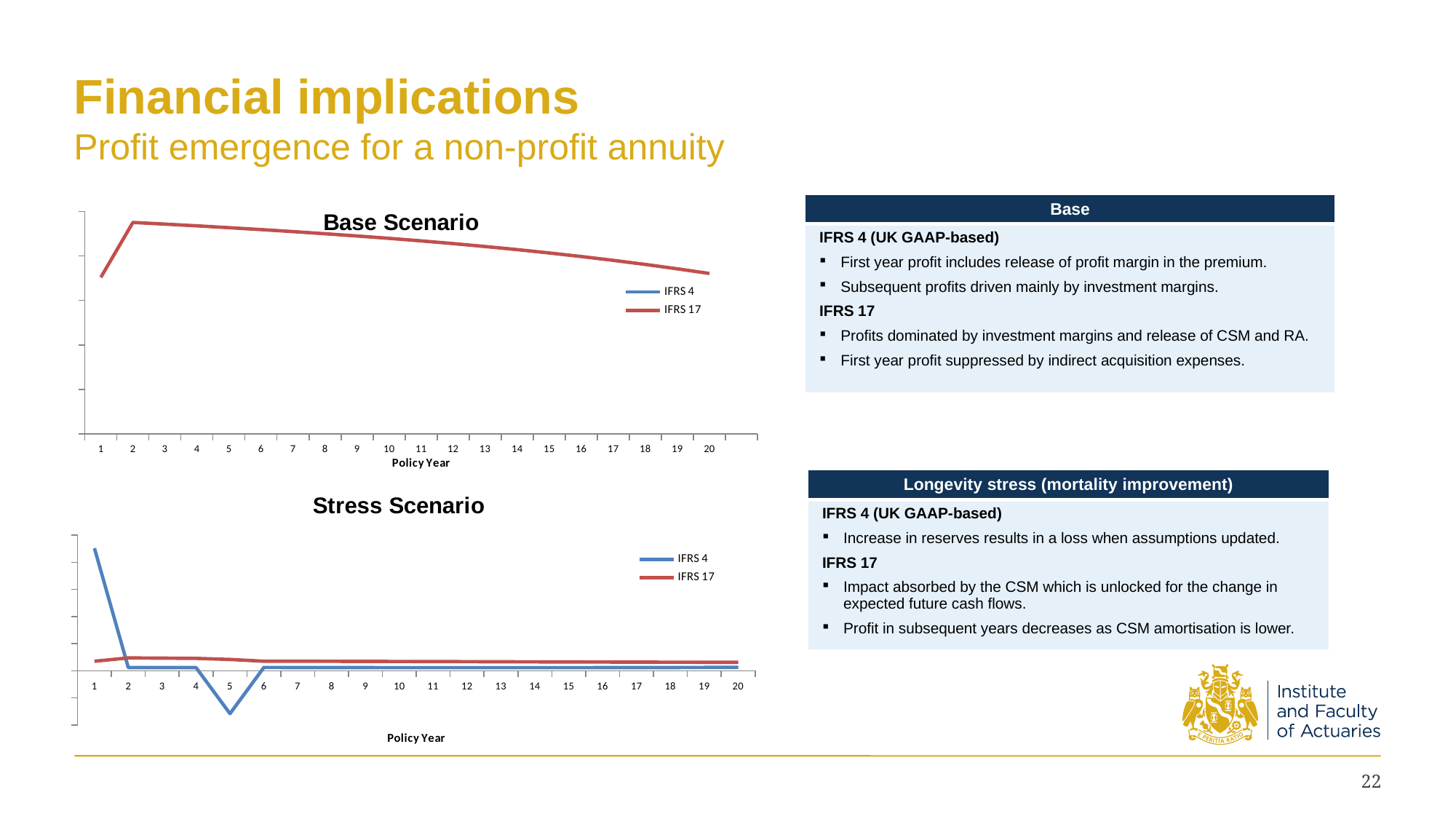
What is the x-axis title of the Stress Scenario chart? Policy Year How many policy years are shown on the x axis of the Base Scenario chart? 20 In the Stress Scenario chart, which series has the larger value at policy year 5, IFRS 4 or IFRS 17? IFRS 17 In the Base Scenario chart, at which policy year is the IFRS 17 line at its lowest? 1 In the Stress Scenario chart, what colour is the IFRS 17 line? Red What type of chart is the Base Scenario chart? Line chart In the Stress Scenario chart, which series has the larger value at policy year 1, IFRS 4 or IFRS 17? IFRS 4 In the Stress Scenario chart, at which policy year does the IFRS 4 line reach its lowest point? 5 How many series does the legend of the Stress Scenario chart list? 2 In the Base Scenario chart, does the IFRS 17 line rise or fall from policy year 2 to policy year 20? Fall In the Base Scenario chart, at which policy year does the IFRS 17 line reach its highest point? 2 In the Stress Scenario chart, at which policy year is the IFRS 4 line at its highest? 1